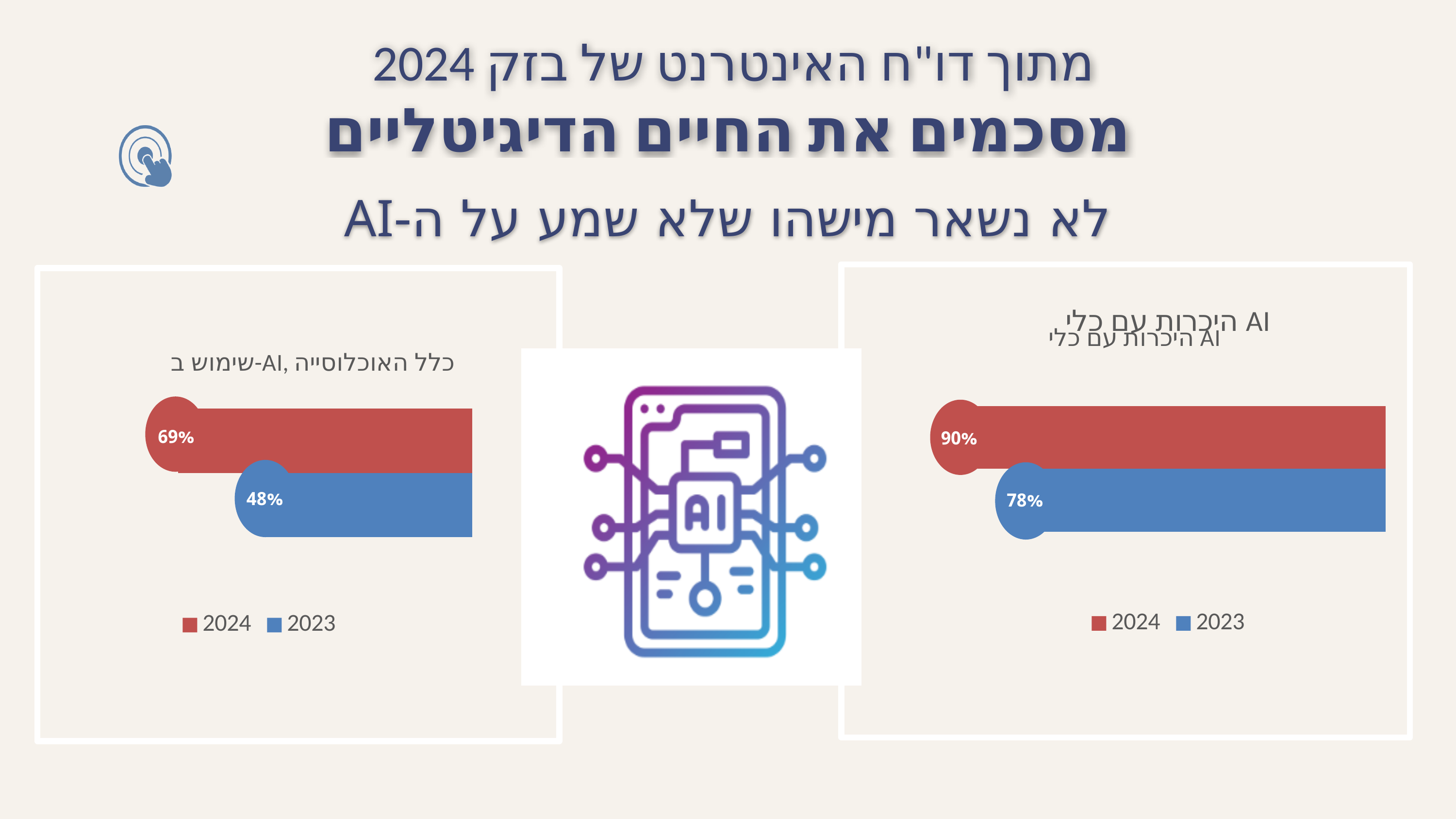
How many series does the legend of the left chart (שימוש ב-AI, כלל האוכלוסייה) list? 2 In the left chart (שימוש ב-AI, כלל האוכלוסייה), what is the difference between the 2024 and 2023 values? 21% What kind of chart is the right chart (היכרות עם כלי AI)? Bar chart In the left chart (שימוש ב-AI, כלל האוכלוסייה), what is the value for 2023? 48% In the right chart (היכרות עם כלי AI), what is the value for 2023? 78% In the left chart (שימוש ב-AI, כלל האוכלוסייה), which colour represents 2023? Blue In the left chart (שימוש ב-AI, כלל האוכלוסייה), what is the value for 2024? 69% In the right chart (היכרות עם כלי AI), which colour represents 2024? Red In the left chart (שימוש ב-AI, כלל האוכלוסייה), which year has the higher value, 2024 or 2023? 2024 In the right chart (היכרות עם כלי AI), which year has the lower value? 2023 In the right chart (היכרות עם כלי AI), what is the value for 2024? 90% In the right chart (היכרות עם כלי AI), what is the difference between the 2024 and 2023 values? 12%